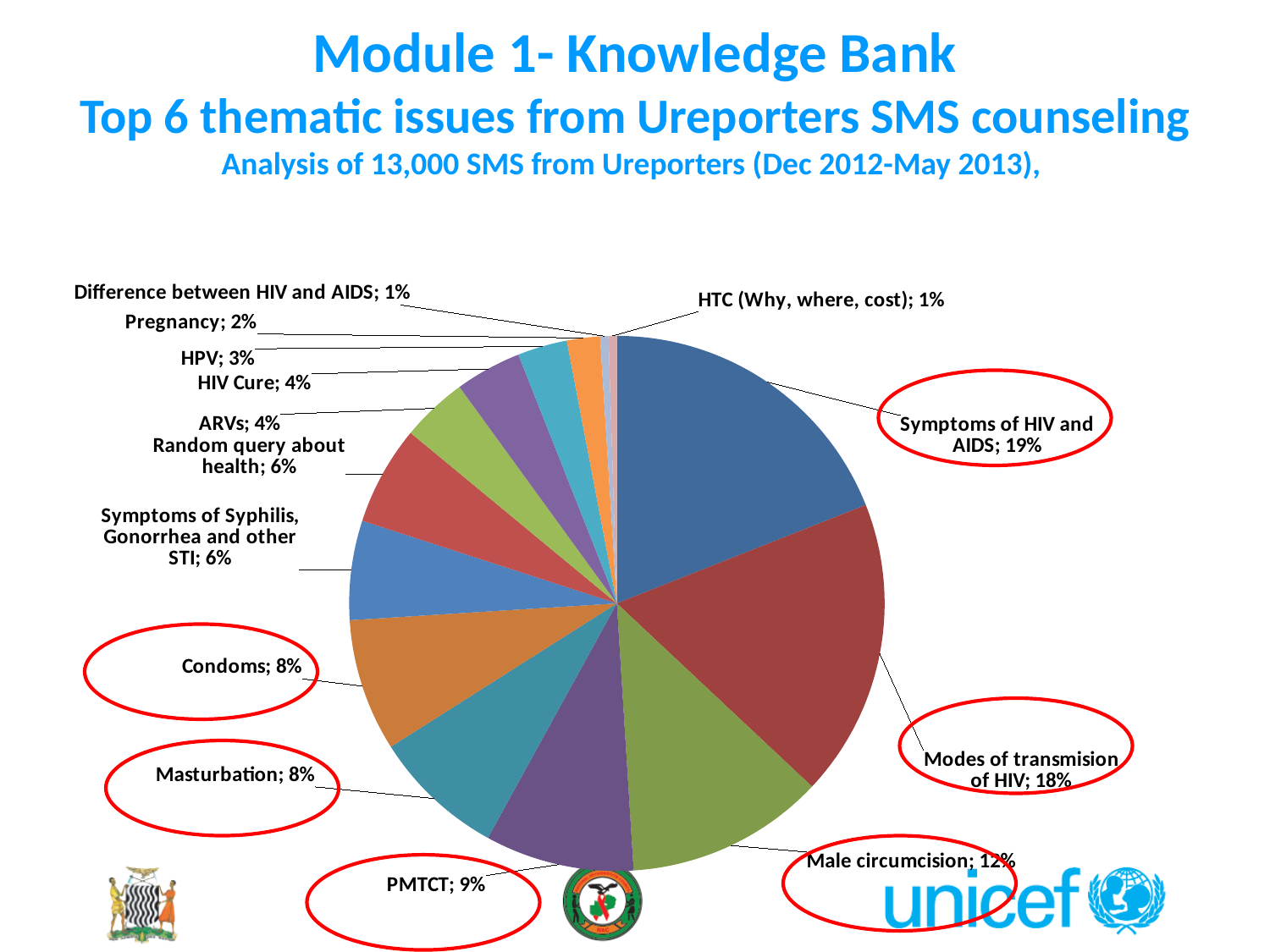
What percentage is shown for HPV? 3% What is the difference in percentage points between Symptoms of HIV and AIDS and Modes of transmision of HIV? 1% Which is larger, the share for Male circumcision or the share for PMTCT? Male circumcision What kind of chart is shown on the slide? Pie chart What percentage is shown for Random query about health? 6% What is the difference in percentage points between Condoms and Pregnancy? 6% How many slices does the pie chart have? 14 What percentage is shown for Male circumcision? 12% Which thematic issue has the largest share of the pie? Symptoms of HIV and AIDS What share of the pie is labelled for Symptoms of HIV and AIDS? 19% According to the subtitle, how many SMS were analysed for this chart? 13,000 What percentage is shown for PMTCT? 9%